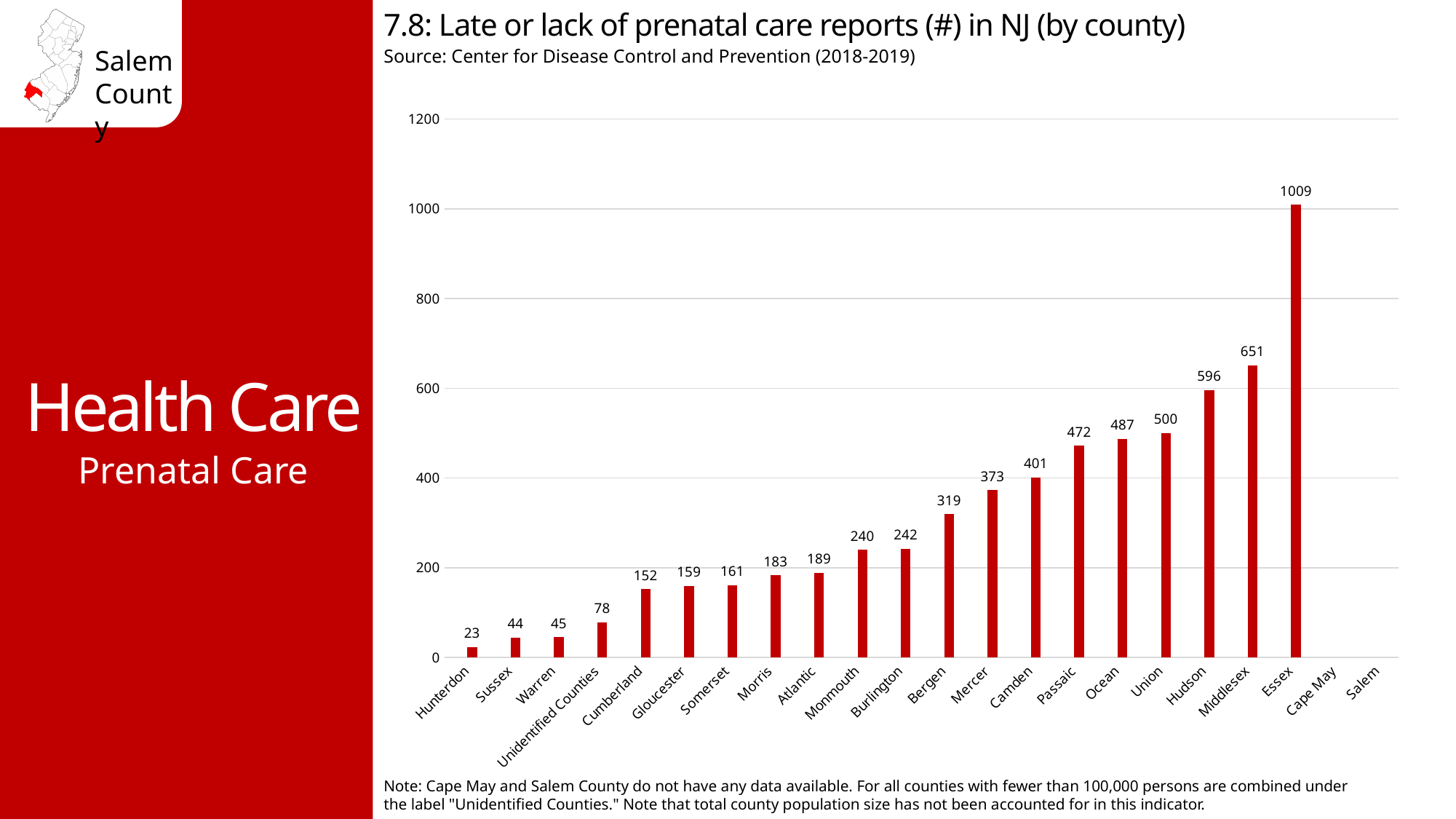
What is the difference between the values for Middlesex and Hudson? 55 Which has a larger value, Bergen or Mercer? Mercer Which county has the lowest number of late or lack of prenatal care reports among those with data? Hunterdon Do the bar values rise or fall from Hunterdon to Essex along the x axis? Rise Which two counties on the x axis have no data available? Cape May and Salem Which county has the highest number of late or lack of prenatal care reports? Essex How many county labels are shown on the x axis? 22 What kind of chart is shown on the slide? Bar chart What is the value shown for Unidentified Counties? 78 What is the number of late or lack of prenatal care reports for Essex? 1009 What is the value shown for Cumberland? 152 Is the value for Union greater or less than 400? greater